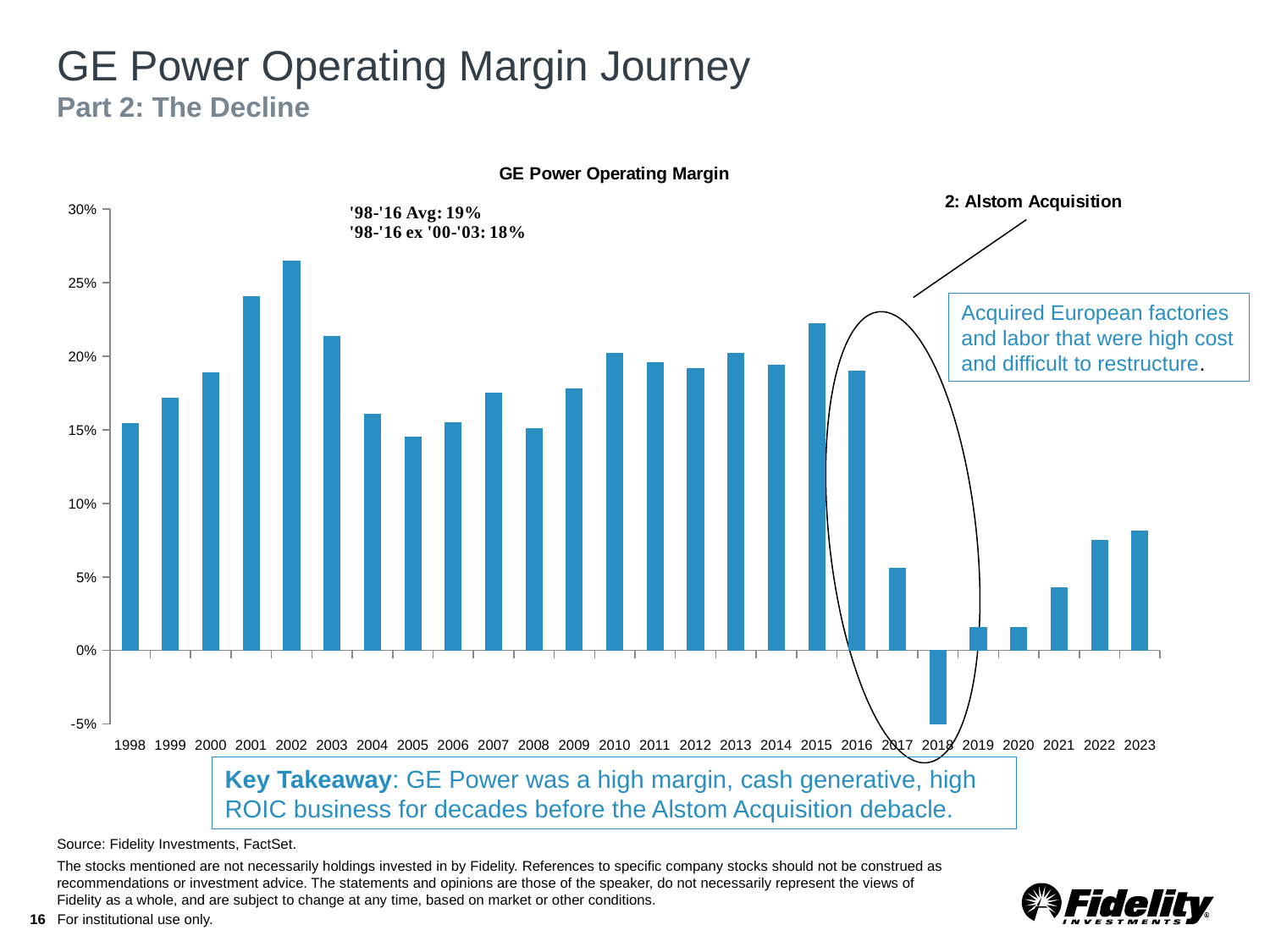
What is the title of the chart? GE Power Operating Margin Which year has the highest operating margin in the chart? 2002 Is the operating margin for 2018 greater or less than 0%? less Is the operating margin for 2002 greater or less than 25%? greater What type of chart is shown on the slide? Bar chart Which year has the lowest operating margin in the chart? 2018 Do the operating margin values rise or fall from 2016 to 2018? fall Is the operating margin for 2019 greater or less than 5%? less Which year has the larger operating margin, 2015 or 2016? 2015 According to the annotation on the chart, what is the '98-'16 average operating margin? 19% How many years are plotted on the x axis of the chart? 26